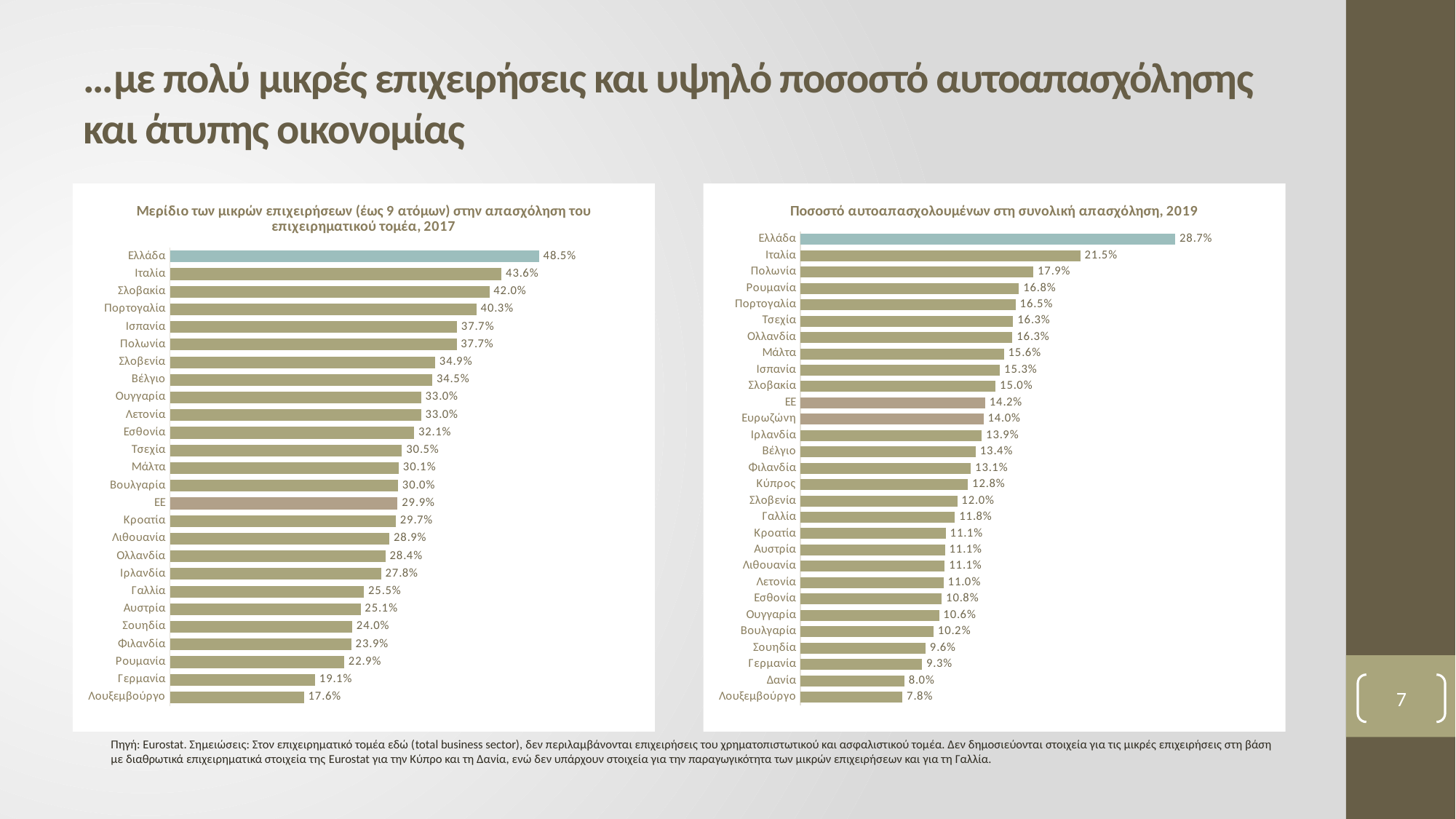
In the left chart (share of small enterprises in employment, 2017), what is the value for ΕΕ? 29.9% In the right chart (self-employed share of total employment, 2019), what is the difference between Ελλάδα and ΕΕ? 14.5% In the right chart (self-employed share of total employment, 2019), what is the value for Ελλάδα? 28.7% In the left chart (share of small enterprises in employment, 2017), how many bars are plotted? 26 In the left chart (share of small enterprises in employment, 2017), what is the difference between Ελλάδα and Ιταλία? 4.9% In the right chart (self-employed share of total employment, 2019), which country has the highest value? Ελλάδα In the right chart (self-employed share of total employment, 2019), which is larger, Πολωνία or Ρουμανία? Πολωνία What type of chart is the left chart on the slide? Bar chart In the right chart (self-employed share of total employment, 2019), how many bars are plotted? 29 In the right chart (self-employed share of total employment, 2019), what is the value for Ευρωζώνη? 14.0% In the left chart (share of small enterprises in employment, 2017), which country has the lowest value? Λουξεμβούργο In the left chart (share of small enterprises in employment, 2017), what is the value for Ελλάδα? 48.5%